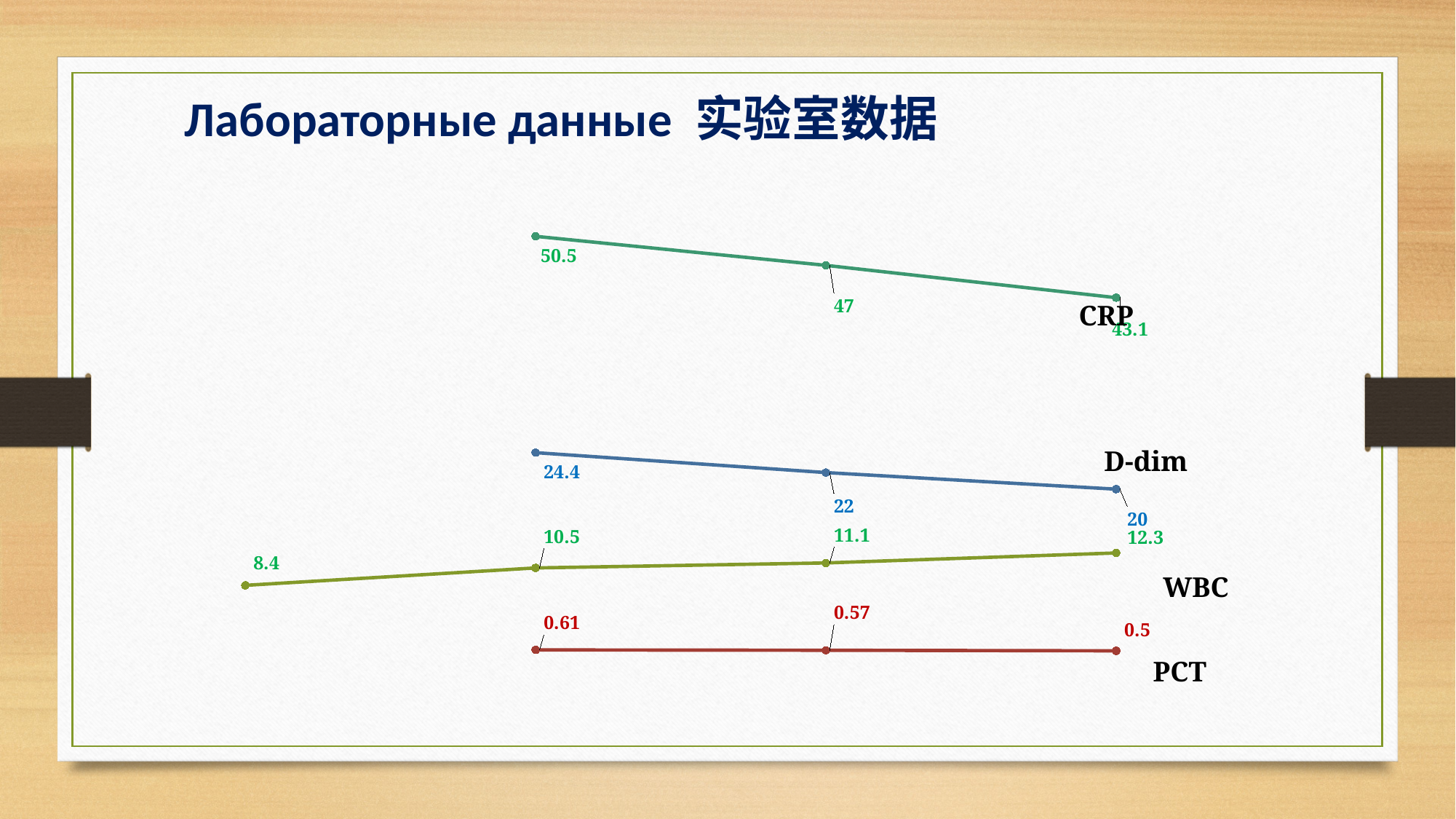
Do the values of the WBC series rise or fall along the x axis? rise How many data points does the WBC series have? 4 Which series has the highest plotted values on the chart? CRP What is the first plotted value of the D-dim series? 24.4 What is the first plotted value of the WBC series? 8.4 What is the last plotted value of the PCT series? 0.5 Do the values of the CRP series rise or fall along the x axis? fall What is the difference between the first and last values of the CRP series? 7.4 How many series are plotted on the chart? 4 What type of chart is shown on the slide? line chart What is the first plotted value of the CRP series? 50.5 What is the last plotted value of the CRP series? 43.1